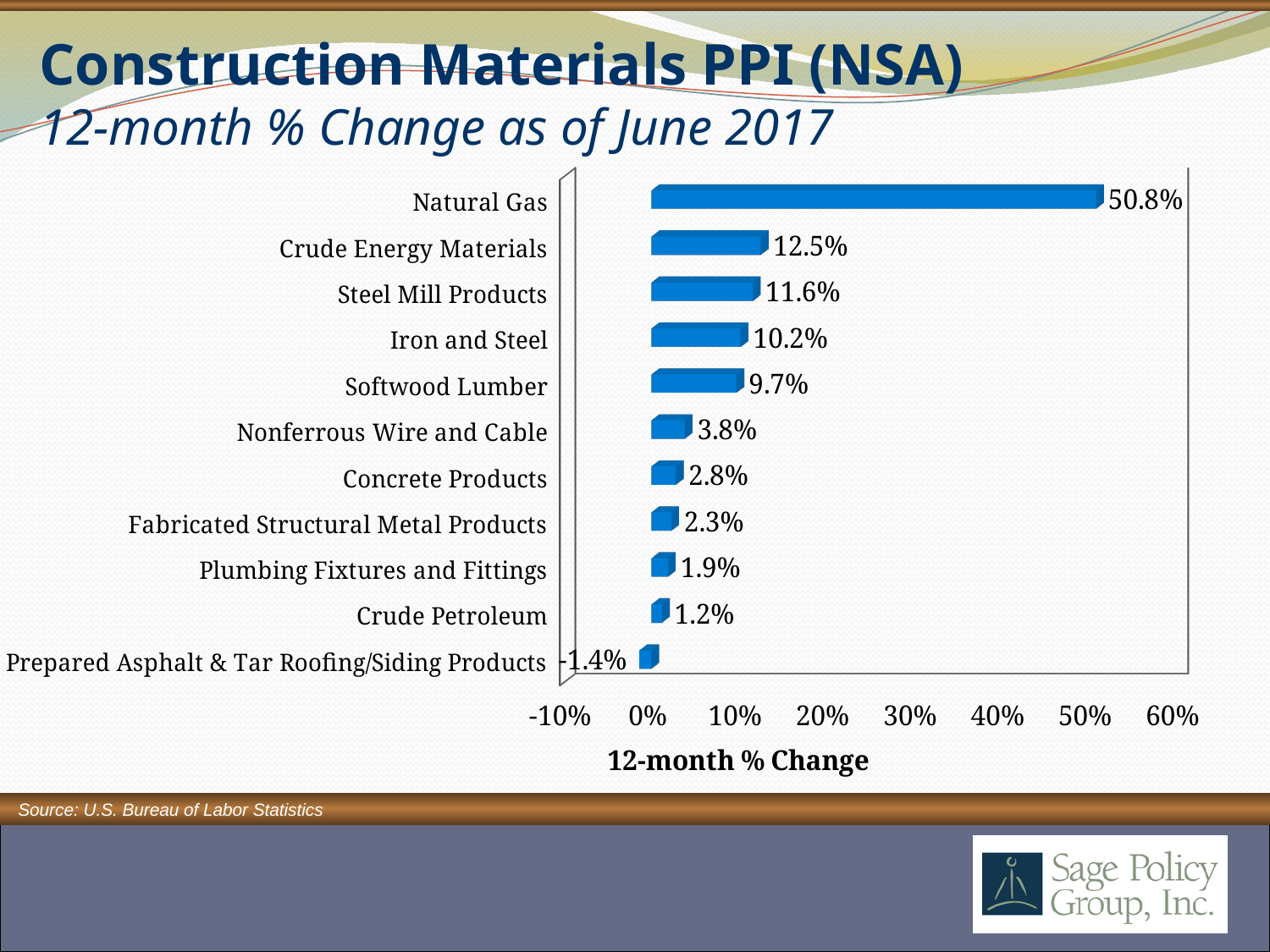
What kind of chart is shown on the slide? Bar chart Which has a larger 12-month % change, Crude Energy Materials or Crude Petroleum? Crude Energy Materials What is the source cited for the chart data? U.S. Bureau of Labor Statistics Is the value for Natural Gas greater or less than 40%? greater What is the 12-month % change for Natural Gas? 50.8% What is the 12-month % change for Prepared Asphalt & Tar Roofing/Siding Products? -1.4% What is the 12-month % change for Softwood Lumber? 9.7% What is the difference between the 12-month % change for Steel Mill Products and Iron and Steel? 1.4% How many categories are shown in the chart? 11 Which category has the highest 12-month % change? Natural Gas Which category has the lowest 12-month % change? Prepared Asphalt & Tar Roofing/Siding Products What is the label of the horizontal axis? 12-month % Change